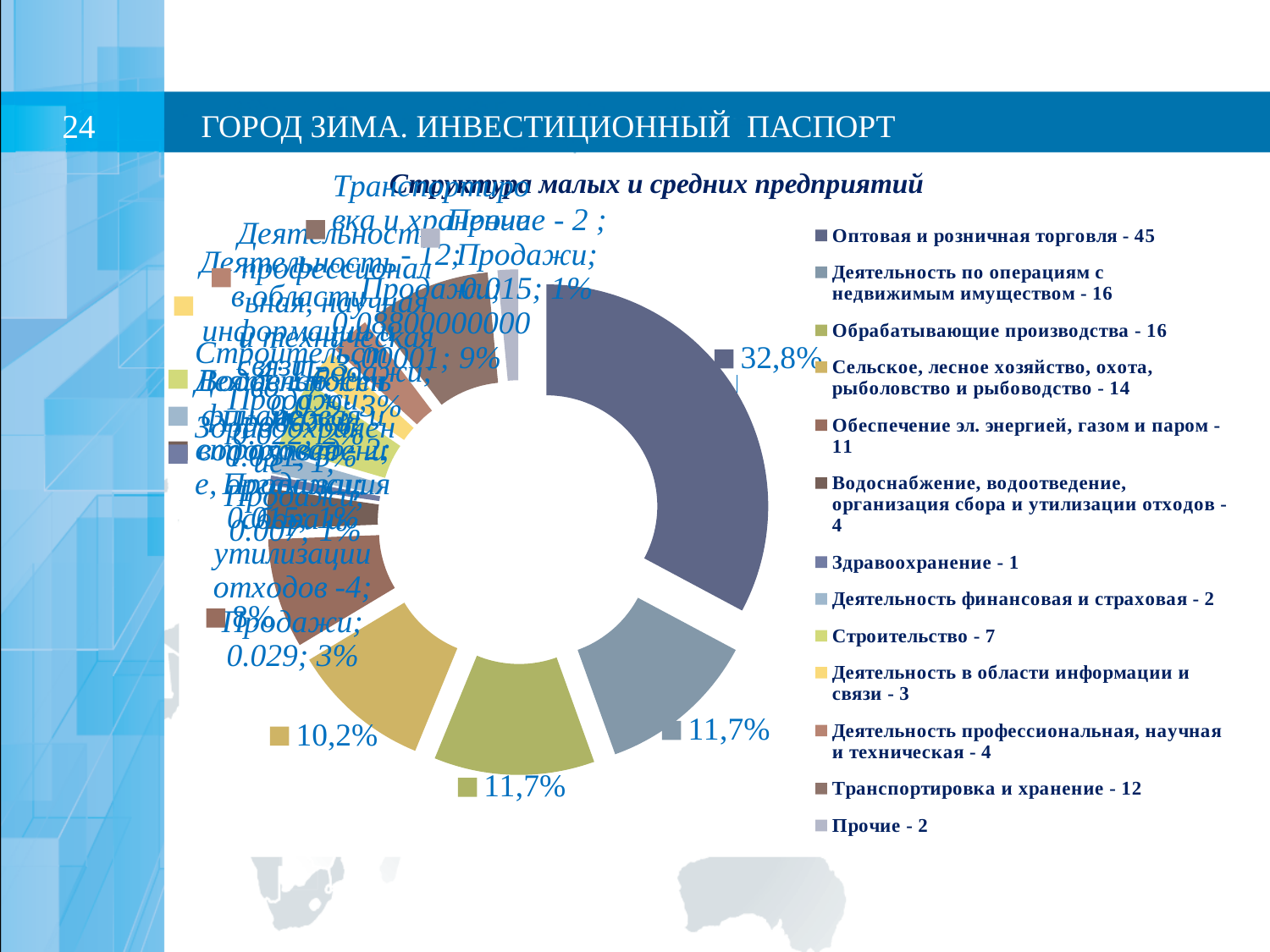
Which category has the smallest number in the legend? Здравоохранение - 1 What number is given in the legend for 'Транспортировка и хранение'? 12 What kind of chart is shown on the slide? Doughnut (pie) chart What is the difference between the 32,8% slice and the 10,2% slice? 22,6% Which category has the largest share of the chart? Оптовая и розничная торговля What number is given in the legend for 'Оптовая и розничная торговля'? 45 Which is larger according to the legend: 'Обрабатывающие производства' or 'Строительство'? Обрабатывающие производства What percentage share is labelled for the largest slice of the chart? 32,8% What percentage share is labelled for the yellow slice (Сельское, лесное хозяйство, охота, рыболовство и рыбоводство)? 10,2% What is the title of the chart? Структура малых и средних предприятий How many categories does the chart legend list? 13 What is the difference between the legend numbers for 'Оптовая и розничная торговля' and 'Обрабатывающие производства'? 29